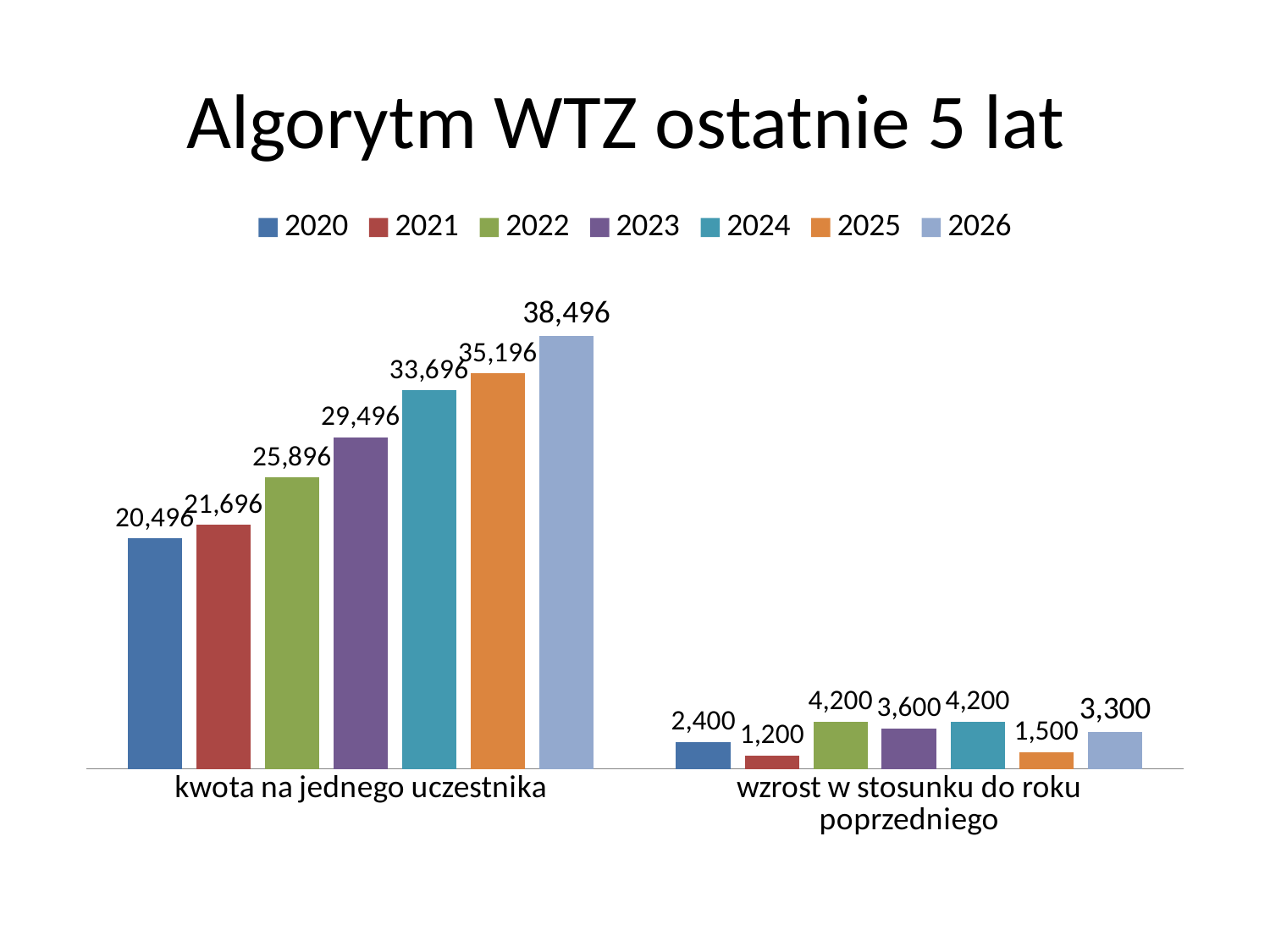
What is the difference between the 2026 and 2025 values in the 'kwota na jednego uczestnika' category? 3,300 Which year has the highest value in the 'kwota na jednego uczestnika' category? 2026 What is the value for 2026 in the 'kwota na jednego uczestnika' category? 38,496 What is the difference between the 2022 and 2021 values in the 'wzrost w stosunku do roku poprzedniego' category? 3,000 How many series does the legend list? 7 In the 'wzrost w stosunku do roku poprzedniego' category, which is larger: the value for 2023 or the value for 2025? 2023 What is the title of the chart? Algorytm WTZ ostatnie 5 lat How many categories are shown on the x axis? 2 What kind of chart is shown on the slide? Bar chart What is the value for 2021 in the 'wzrost w stosunku do roku poprzedniego' category? 1,200 Which year has the lowest value in the 'wzrost w stosunku do roku poprzedniego' category? 2021 What is the value for 2023 in the 'kwota na jednego uczestnika' category? 29,496